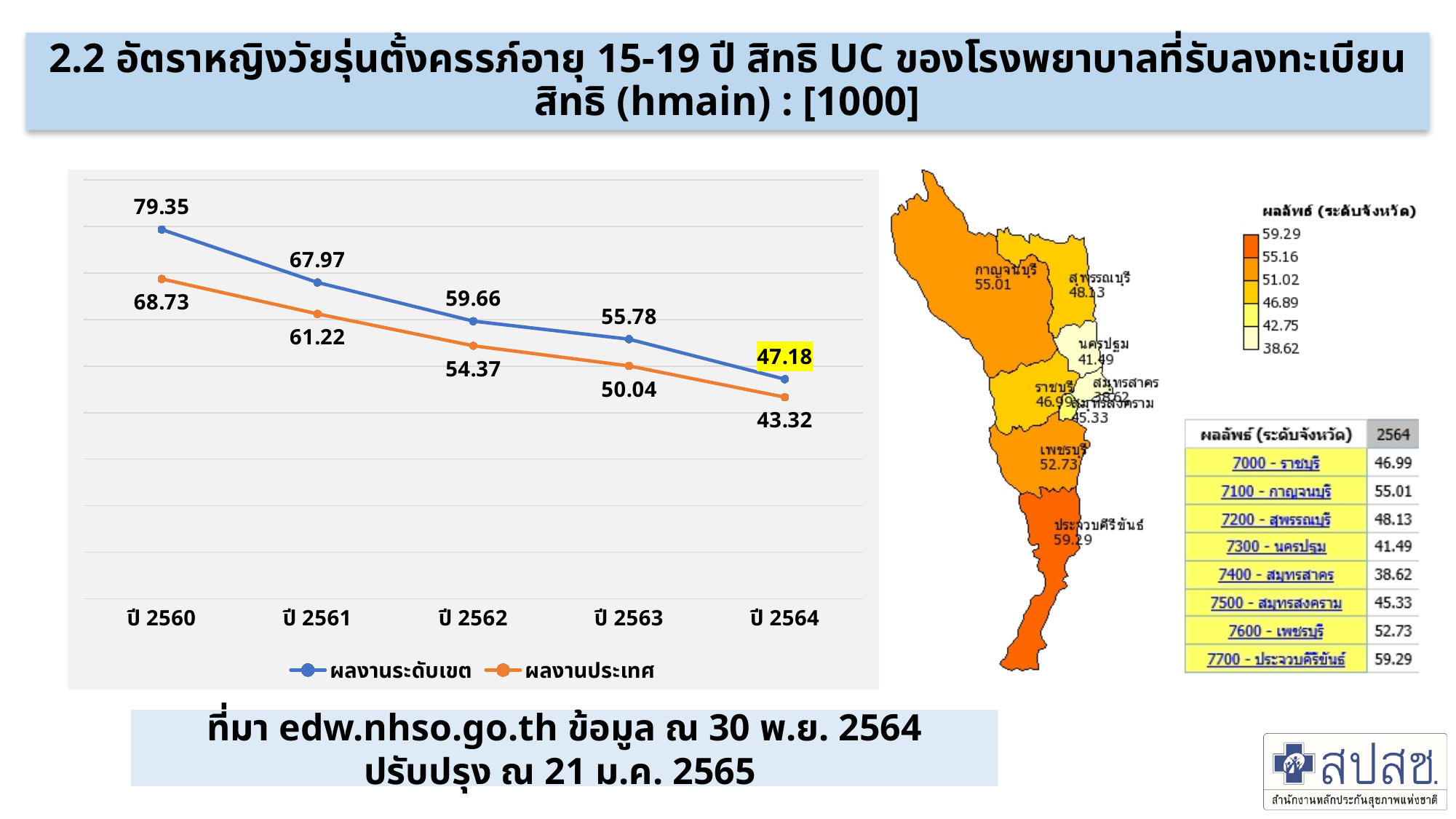
In the line chart, what is the value of ผลงานระดับเขต for ปี 2560? 79.35 How many series does the legend of the line chart list? 2 In the line chart, do the values of ผลงานระดับเขต rise or fall from ปี 2560 to ปี 2564? fall In the line chart, what is the difference between ผลงานระดับเขต and ผลงานประเทศ in ปี 2561? 6.75 In the line chart, in which year is ผลงานประเทศ lowest? ปี 2564 How many years are shown on the x axis of the line chart? 5 What kind of chart is shown on the left of the slide? line chart In the line chart, what is the value of ผลงานประเทศ for ปี 2563? 50.04 In the line chart, what is the value of ผลงานระดับเขต for ปี 2564? 47.18 In the line chart, in which year is ผลงานระดับเขต highest? ปี 2560 In the line chart, what is the value of ผลงานประเทศ for ปี 2562? 54.37 In the line chart, which series has the larger value in ปี 2563, ผลงานระดับเขต or ผลงานประเทศ? ผลงานระดับเขต